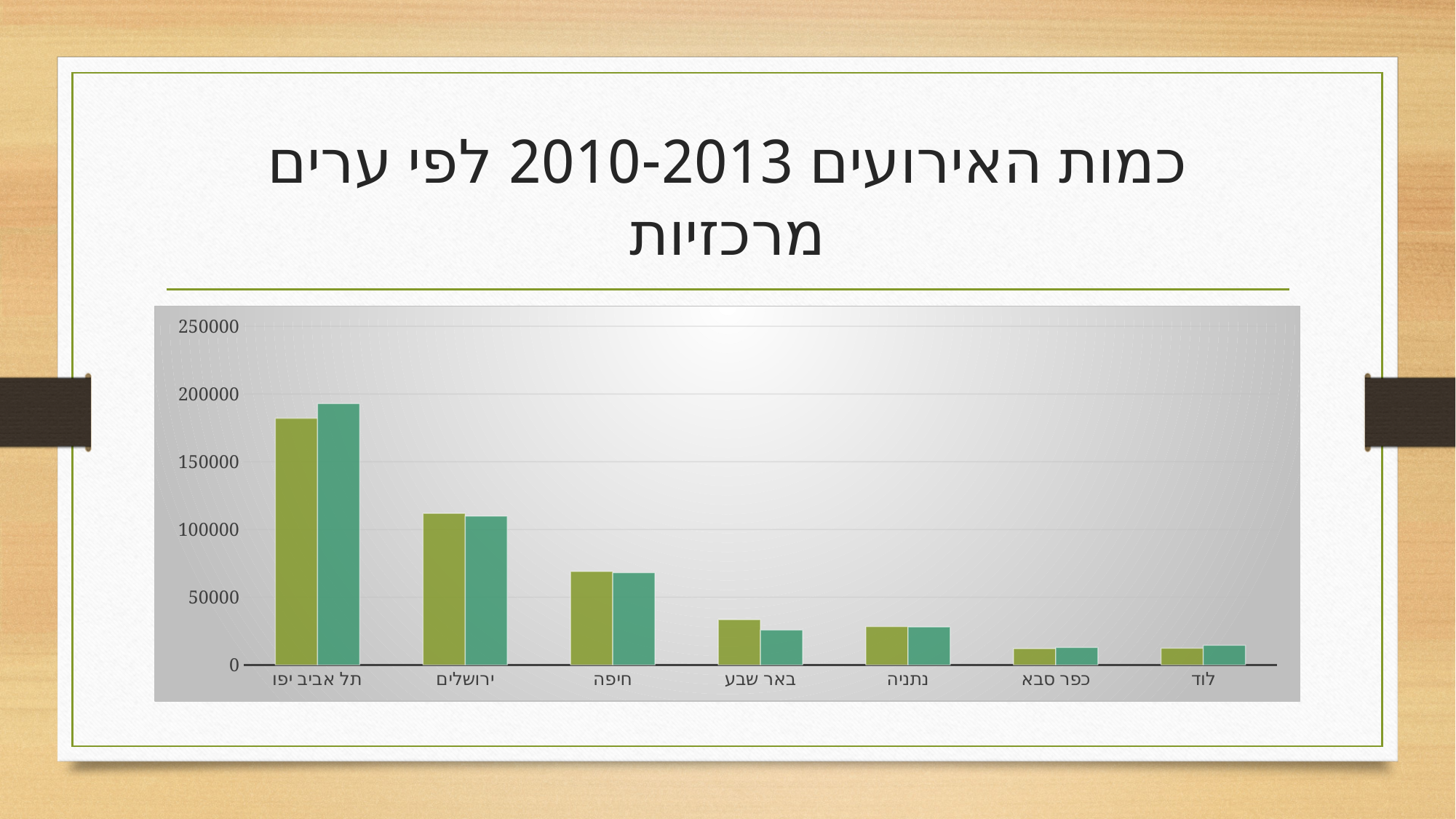
Is the value of the left (green) bar for באר שבע greater or less than 50000? less Which city has the highest values in the chart? תל אביב יפו How many cities (categories) are shown on the x axis of the chart? 7 Is the value of the left (green) bar for תל אביב יפו greater or less than 150000? greater How many bars are plotted for each city in the chart? 2 Is the value of the right (teal) bar for חיפה greater or less than 50000? greater Which city has larger values, ירושלים or חיפה? ירושלים What kind of chart is shown on the slide? bar chart What is the title of the slide containing the chart? כמות האירועים 2010-2013 לפי ערים מרכזיות Do the values generally rise or fall moving from left to right along the x axis? fall